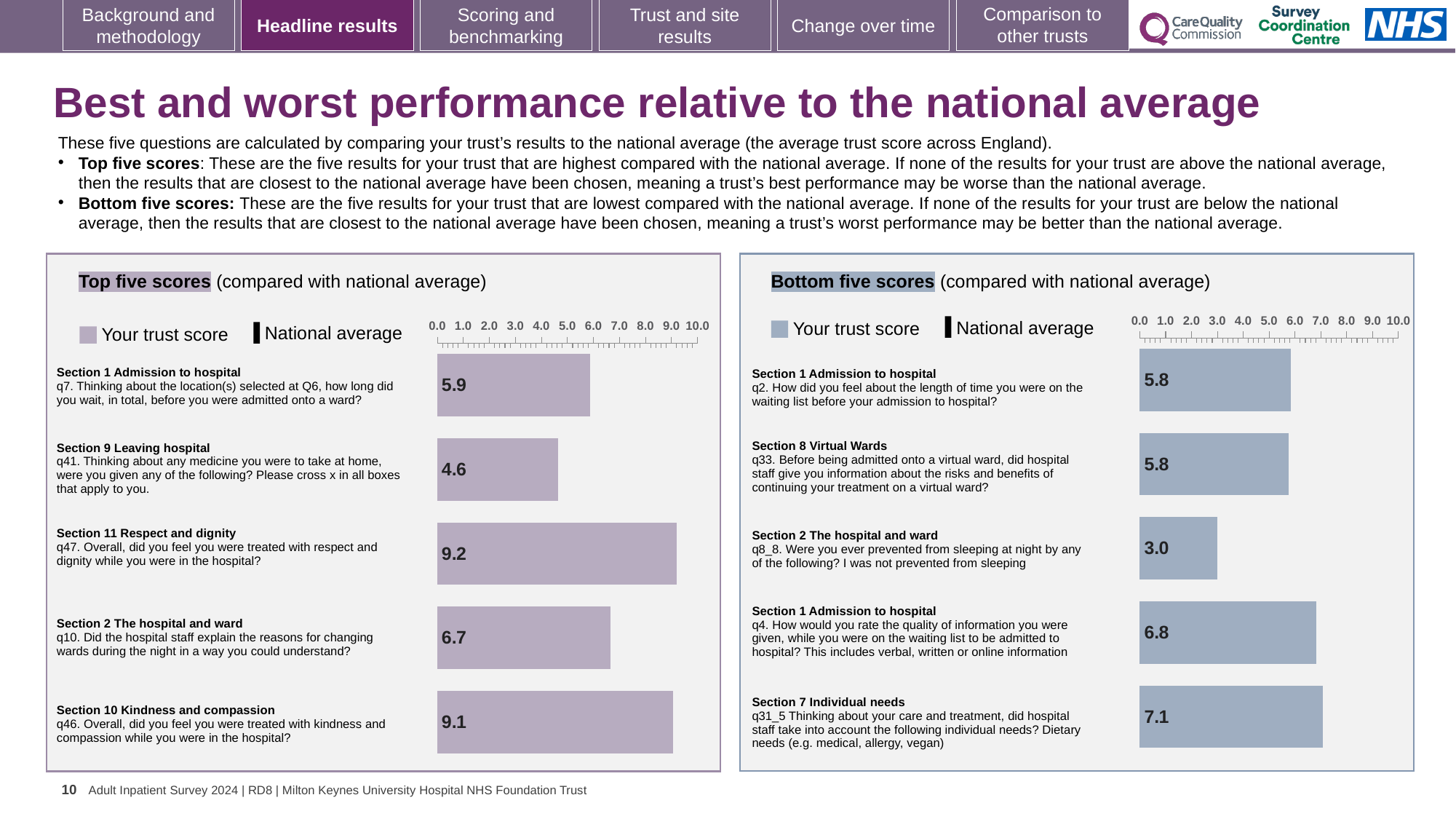
In the Top five scores chart, which question has the lowest trust score? q41 (Section 9 Leaving hospital) In the Top five scores chart, which question has the highest trust score? q47 (Section 11 Respect and dignity) In the Bottom five scores chart, which question has the lowest trust score? q8_8 (Section 2 The hospital and ward) In the Bottom five scores chart, what is the difference between the trust scores for q31_5 and q8_8? 4.1 How many questions are plotted in the Bottom five scores chart? 5 In the Bottom five scores chart, which question has the highest trust score? q31_5 (Section 7 Individual needs) In the Top five scores chart, which has the larger trust score: q7 or q10? q10 What type of chart is the Top five scores chart? Bar chart In the Top five scores chart, what is the trust score for q47 (Overall, did you feel you were treated with respect and dignity while you were in the hospital?)? 9.2 In the Bottom five scores chart, is the trust score for q2 greater or less than 5.0? greater In the Bottom five scores chart, what is the trust score for q8_8 (Were you ever prevented from sleeping at night by any of the following? I was not prevented from sleeping)? 3.0 In the Top five scores chart, what is the difference between the trust scores for q47 and q41? 4.6